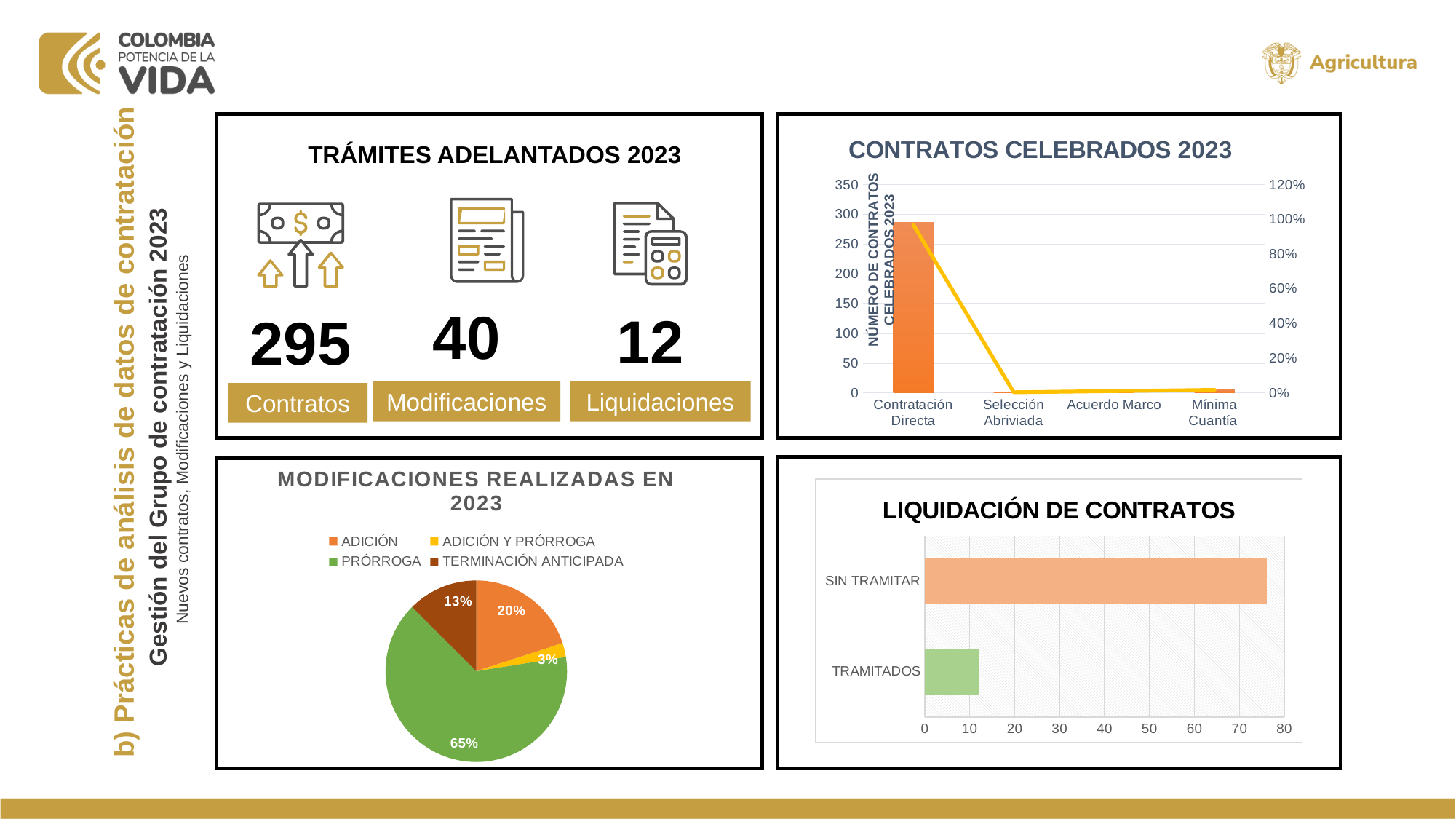
In the LIQUIDACIÓN DE CONTRATOS chart, is the value for SIN TRAMITAR greater or less than 70? greater In the MODIFICACIONES REALIZADAS EN 2023 chart, what share does ADICIÓN Y PRÓRROGA have? 3% How many categories are shown on the x axis of the CONTRATOS CELEBRADOS 2023 chart? 4 In the LIQUIDACIÓN DE CONTRATOS chart, which category has the larger value, SIN TRAMITAR or TRAMITADOS? SIN TRAMITAR In the MODIFICACIONES REALIZADAS EN 2023 chart, which category has the smallest slice? ADICIÓN Y PRÓRROGA In the CONTRATOS CELEBRADOS 2023 chart, is the bar for Contratación Directa greater or less than 250? greater In the MODIFICACIONES REALIZADAS EN 2023 chart, what share does ADICIÓN have? 20% In the MODIFICACIONES REALIZADAS EN 2023 chart, what is the difference in percentage points between PRÓRROGA and TERMINACIÓN ANTICIPADA? 52 In the CONTRATOS CELEBRADOS 2023 chart, which category has the highest number of contracts? Contratación Directa In the MODIFICACIONES REALIZADAS EN 2023 chart, what share does PRÓRROGA have? 65% How many entries does the legend of the MODIFICACIONES REALIZADAS EN 2023 chart list? 4 What kind of chart is MODIFICACIONES REALIZADAS EN 2023? Pie chart